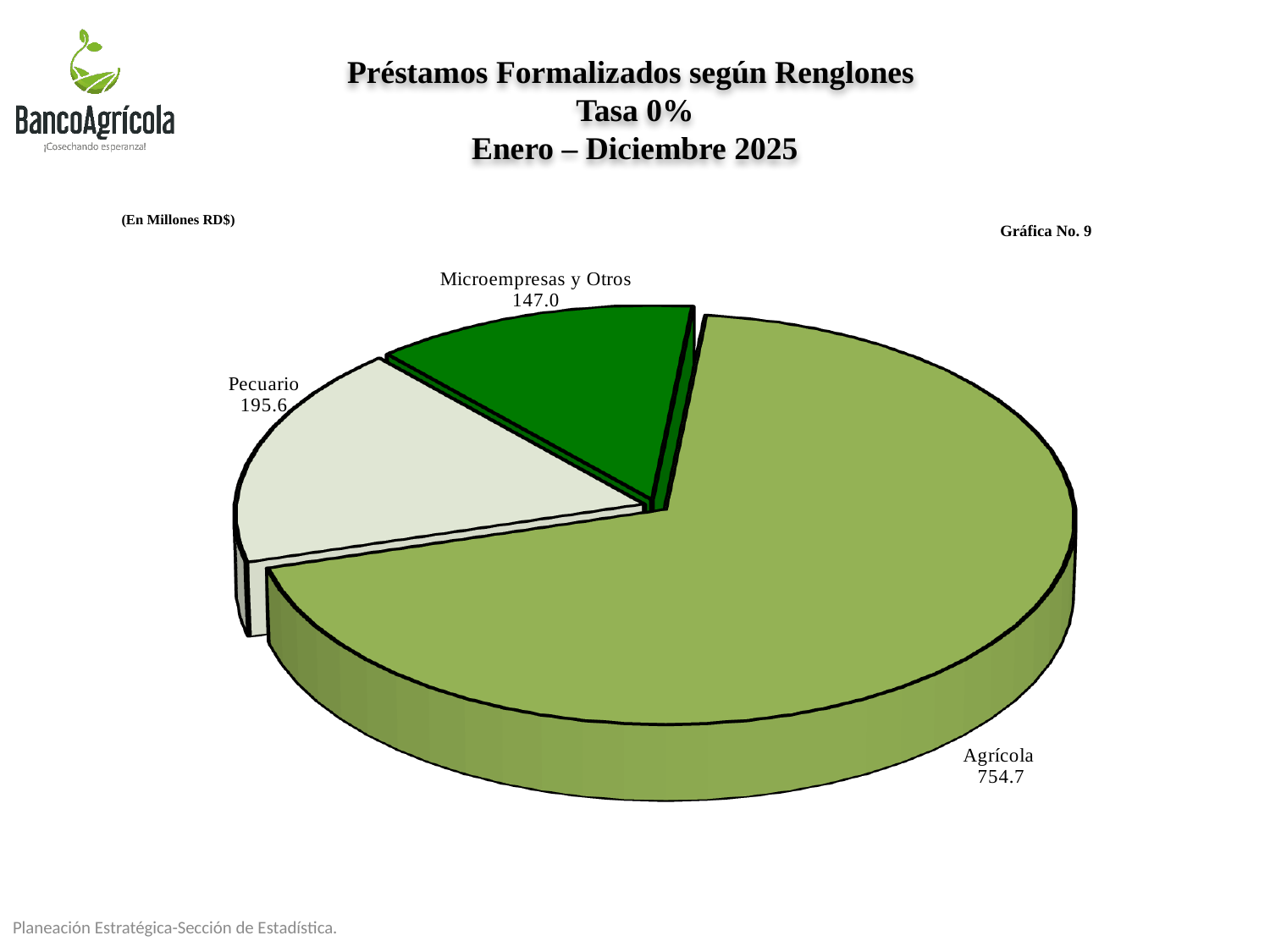
In what units are the values in the chart expressed? En Millones RD$ Which is larger, the value for Pecuario or the value for Microempresas y Otros? Pecuario What type of chart is shown on the slide? Pie chart What is the difference between the values for Agrícola and Pecuario? 559.1 Which category has the largest slice of the pie? Agrícola What is the value for Agrícola? 754.7 What is the value for Microempresas y Otros? 147.0 What share of the pie does Agrícola represent, to one decimal place? 68.8% What is the value for Pecuario? 195.6 What is the difference between the values for Pecuario and Microempresas y Otros? 48.6 How many categories are shown in the pie chart? 3 Which category has the smallest slice of the pie? Microempresas y Otros